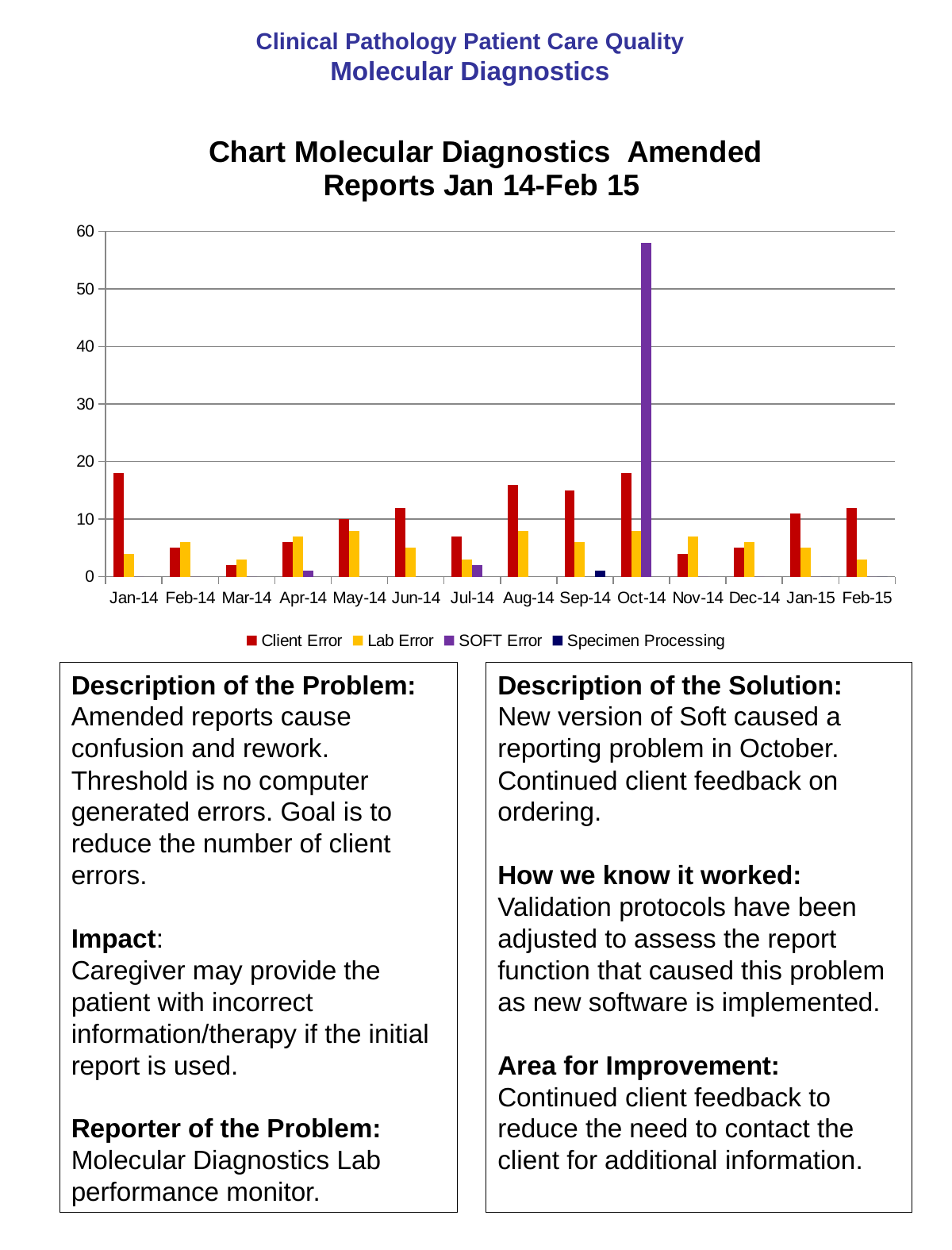
Is the SOFT Error value for Oct-14 greater or less than 50? greater In which month is the Client Error bar the lowest? Mar-14 Is the Lab Error value for Feb-14 greater or less than 10? less What kind of chart is shown on the slide? bar chart Is the Client Error value for Jan-14 greater or less than 10? greater How many series does the chart legend list? 4 Which series has the single tallest bar in the chart? SOFT Error Which is larger for Client Error, Jan-14 or Feb-14? Jan-14 Which is larger in Aug-14, the Client Error bar or the Lab Error bar? Client Error In which month does the SOFT Error series have its tallest bar? Oct-14 What is the title of the chart? Chart Molecular Diagnostics Amended Reports Jan 14-Feb 15 How many months are shown along the x axis of the chart? 14